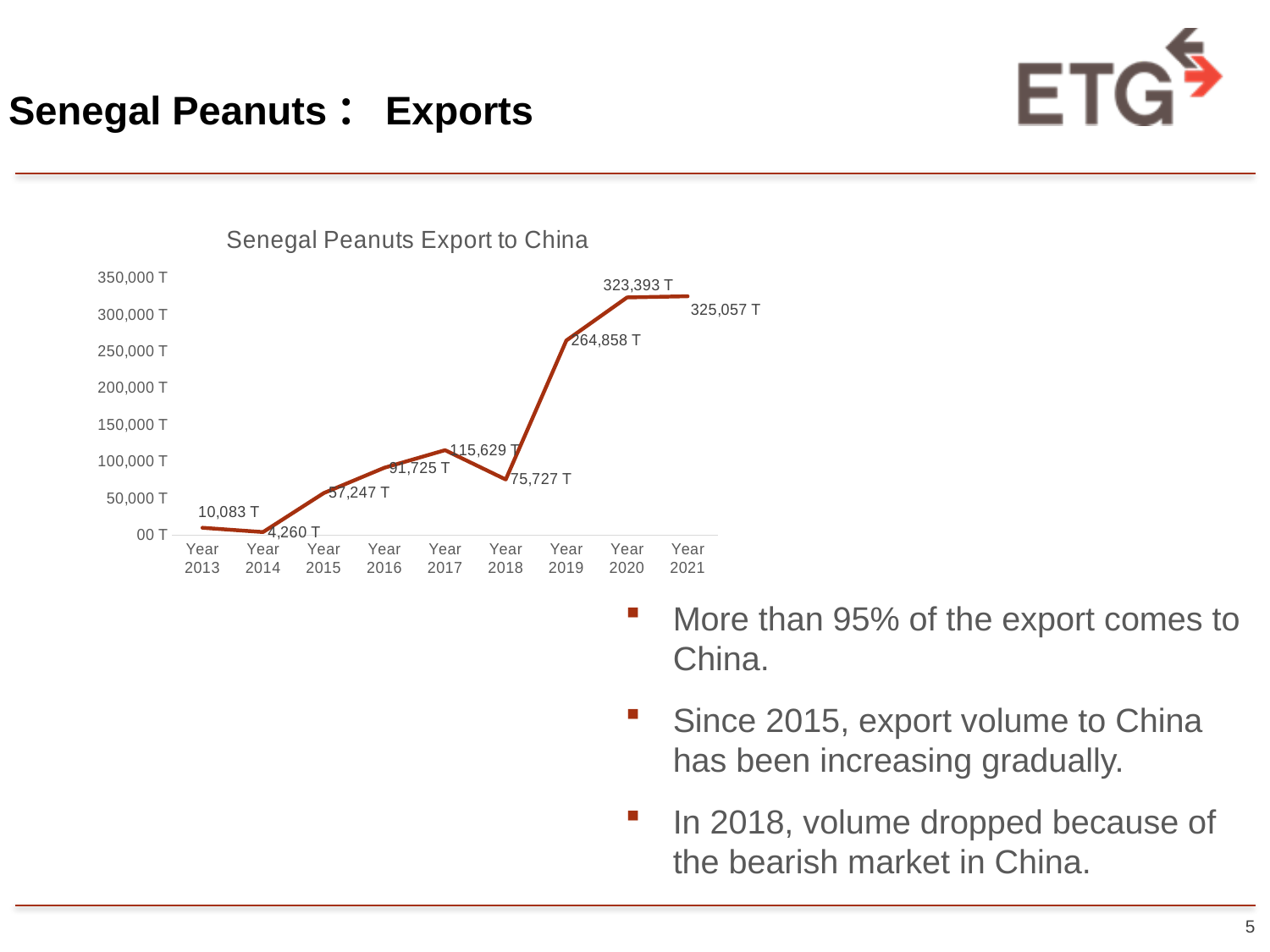
What is the export volume to China in Year 2018? 75,727 T How many years are plotted on the chart? 9 What is the export volume to China in Year 2015? 57,247 T What is the export volume to China in Year 2020? 323,393 T What kind of chart is shown on the slide? line chart Does the export volume rise or fall from Year 2018 to Year 2021? rise What is the difference in export volume between Year 2019 and Year 2018? 189,131 T Which year has a larger export volume, Year 2017 or Year 2018? Year 2017 What is the difference in export volume between Year 2021 and Year 2020? 1,664 T Which year has the highest export volume to China? Year 2021 Which year has the lowest export volume to China? Year 2014 Is the export volume for Year 2019 greater or less than 250,000 T? greater